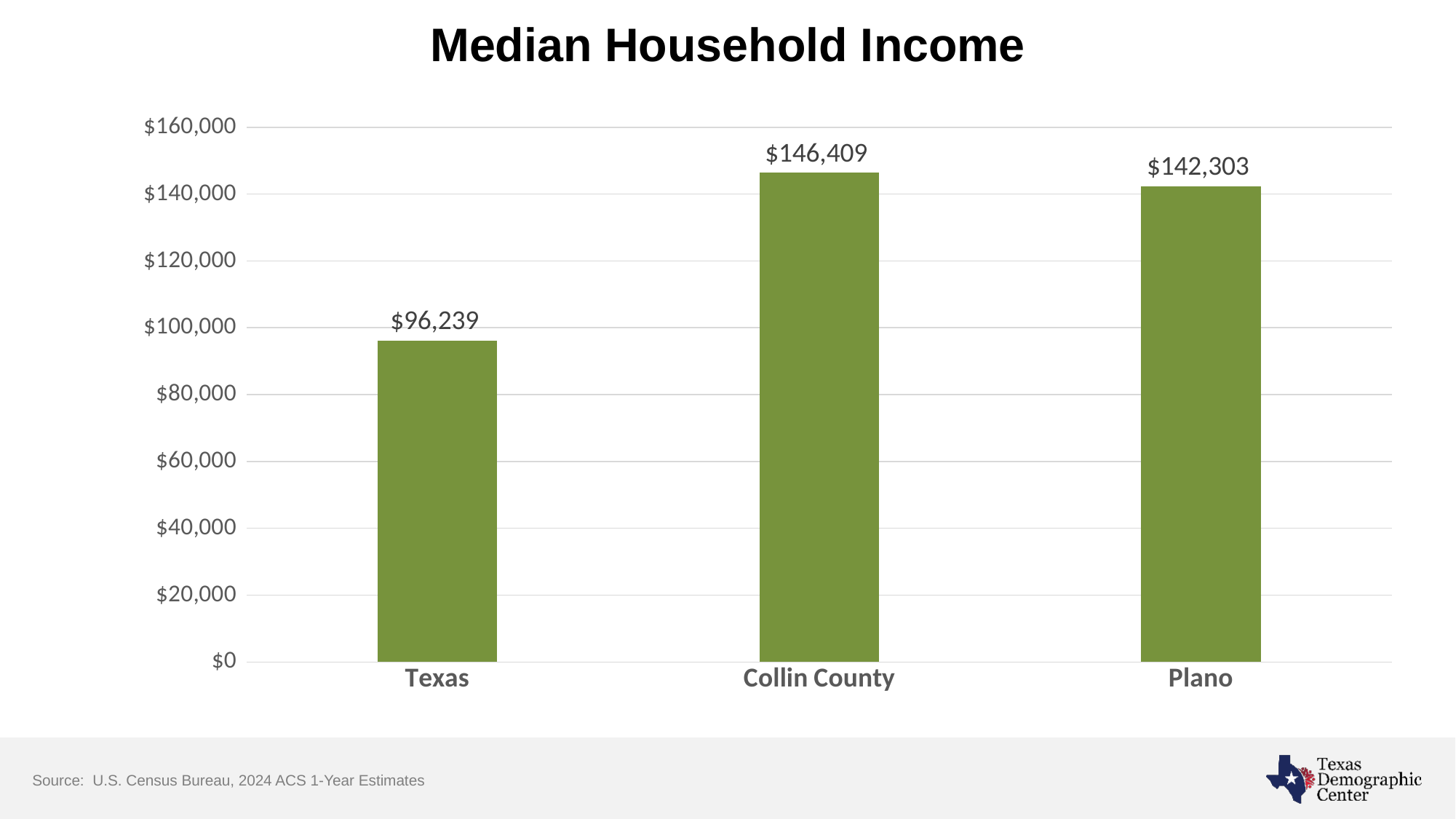
Which has a higher median household income, Plano or Texas? Plano What is the median household income for Plano? $142,303 What is the median household income for Collin County? $146,409 Which category has the lowest median household income? Texas Is the value for Texas greater or less than $100,000? less How many categories are shown in the chart? 3 What kind of chart is shown on the slide? Bar chart What is the title of the chart? Median Household Income What is the difference between the median household income of Collin County and Texas? $50,170 What is the median household income for Texas? $96,239 Which category has the highest median household income? Collin County What is the difference between the median household income of Collin County and Plano? $4,106